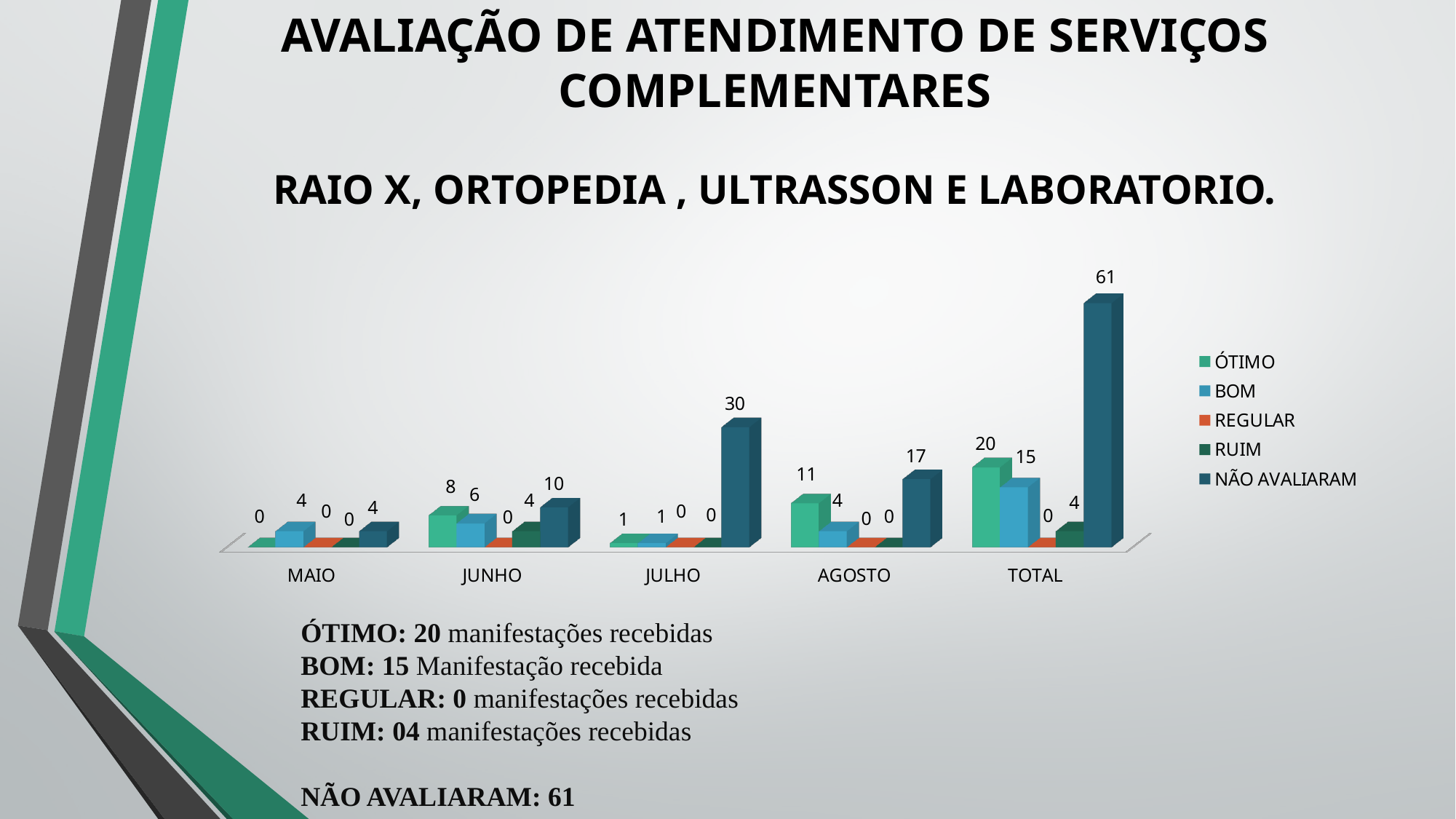
Which is larger, the ÓTIMO value for JUNHO or the ÓTIMO value for AGOSTO? AGOSTO What is the value of ÓTIMO for AGOSTO? 11 Which category has the highest NÃO AVALIARAM value? TOTAL What is the value of BOM for JUNHO? 6 What is the value of RUIM for TOTAL? 4 What type of chart is shown on the slide? bar chart How many series does the chart legend list? 5 Among the months MAIO, JUNHO, JULHO and AGOSTO, which has the lowest ÓTIMO value? MAIO Which legend entry is shown in orange? REGULAR How many categories are shown on the x axis of the chart? 5 What is the difference between the NÃO AVALIARAM values for JULHO and AGOSTO? 13 What is the value of NÃO AVALIARAM for JULHO? 30